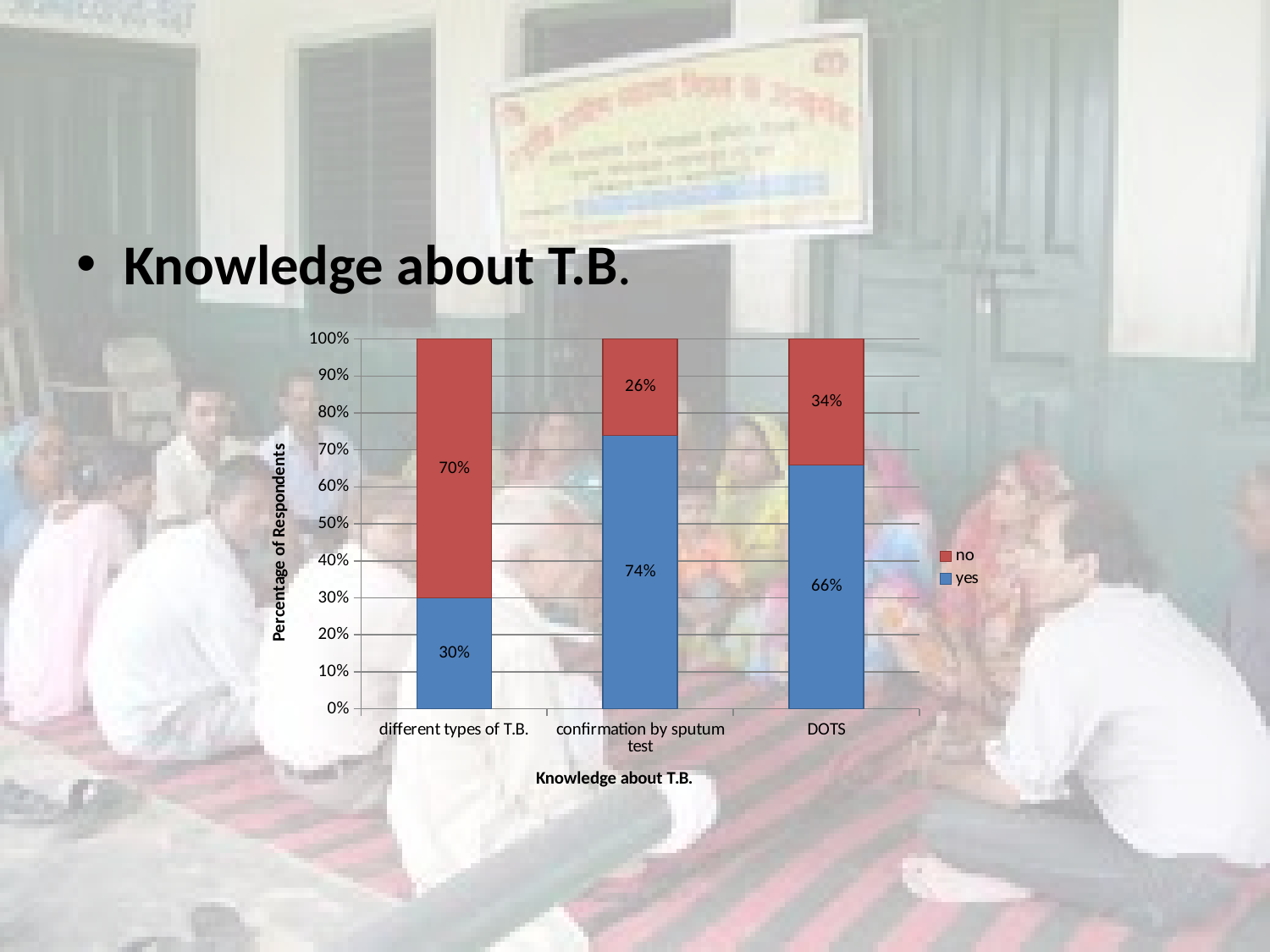
How many categories are shown on the x axis? 3 Which is larger: the 'yes' percentage for confirmation by sputum test or the 'yes' percentage for DOTS? confirmation by sputum test What percentage of respondents answered 'yes' for knowledge of DOTS? 66% Which category has the lowest 'yes' percentage? different types of T.B. Which category has the highest 'yes' percentage? confirmation by sputum test What percentage of respondents answered 'no' for knowledge of confirmation by sputum test? 26% What is the label of the y axis? Percentage of Respondents What percentage of respondents answered 'no' for knowledge of DOTS? 34% How many series does the legend list? 2 What is the difference between the 'no' percentage for different types of T.B. and the 'no' percentage for DOTS? 36% What percentage of respondents answered 'yes' for knowledge of different types of T.B.? 30% What kind of chart is shown on the slide? stacked bar chart